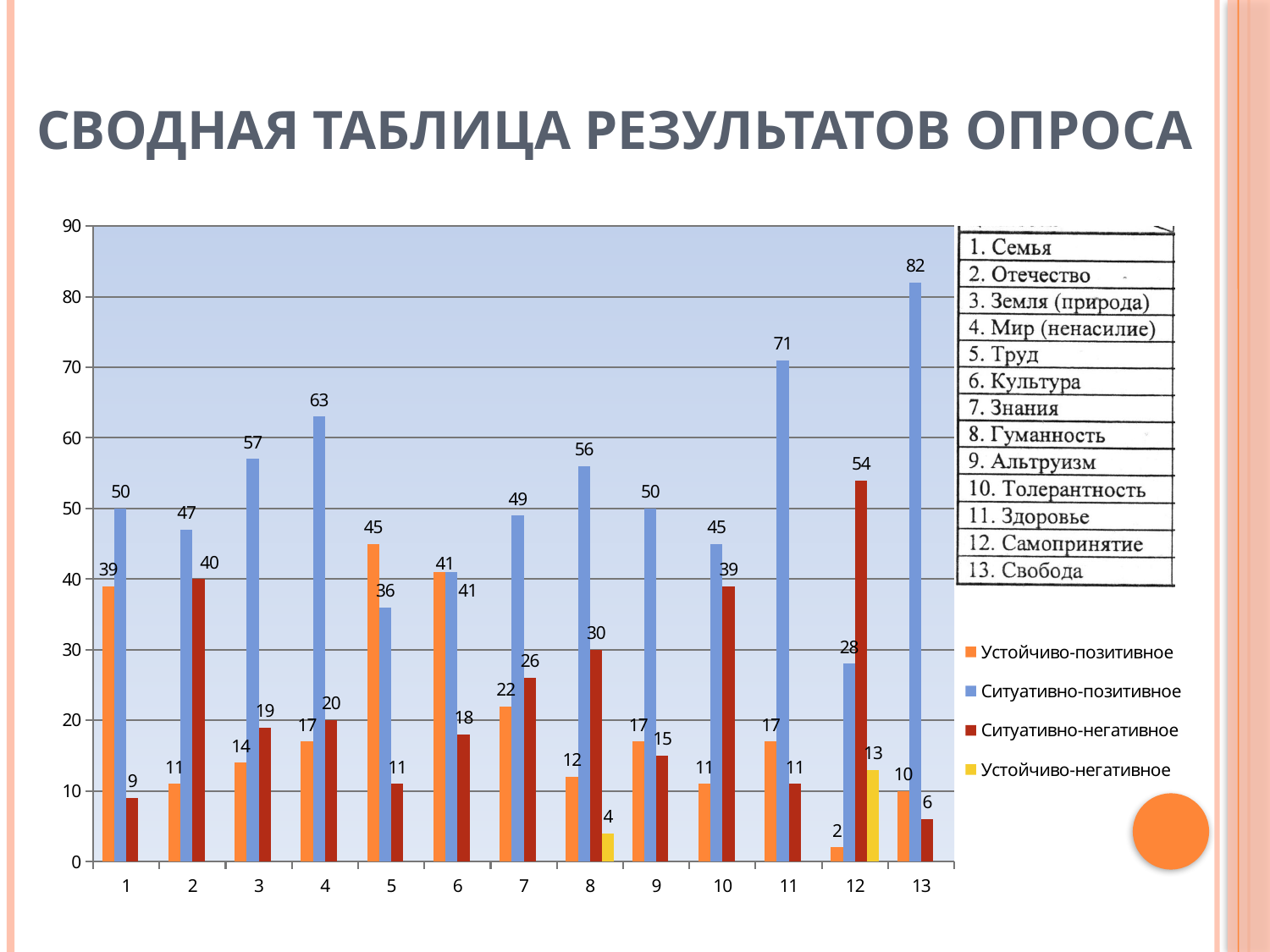
What is the value of the Устойчиво-негативное series for category 8? 4 What is the difference between the Ситуативно-позитивное and Устойчиво-позитивное values for category 11? 54 How many series does the legend list? 4 What kind of chart is shown on the slide? Bar chart What is the value of the Ситуативно-позитивное series for category 13? 82 Which category has the lowest value in the Устойчиво-позитивное series? 12 Which category has the highest value in the Ситуативно-позитивное series? 13 For category 5, which is larger: the Устойчиво-позитивное value or the Ситуативно-позитивное value? Устойчиво-позитивное How many categories are shown on the x axis? 13 Which series is shown in yellow in the legend? Устойчиво-негативное What is the value of the Устойчиво-позитивное series for category 5? 45 What is the value of the Ситуативно-негативное series for category 12? 54